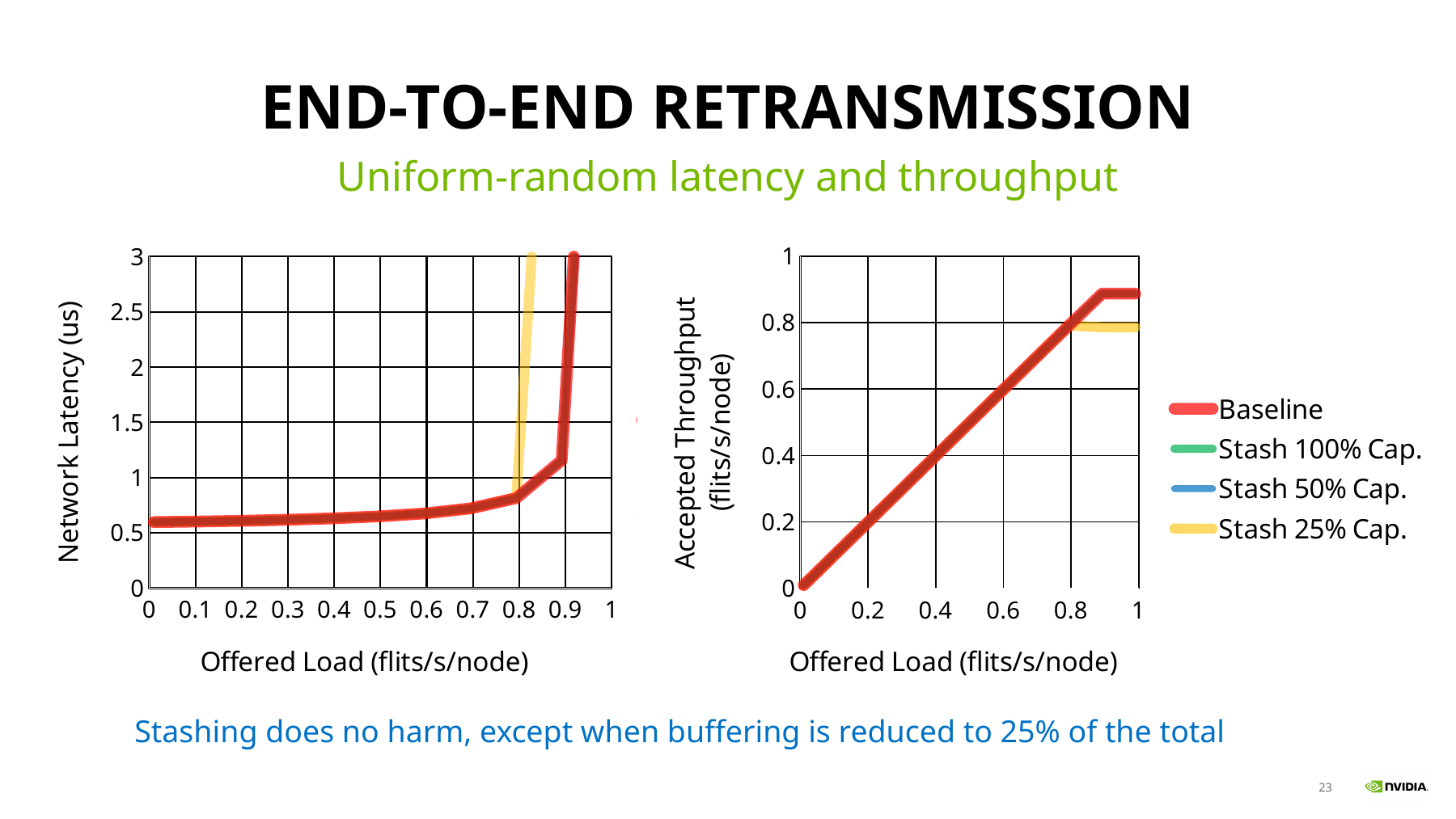
In the right chart, is the Baseline accepted throughput at an offered load of 0.2 greater or less than 0.4? less How many series does the legend list? 4 In the right chart, at an offered load of 1, which series has the higher accepted throughput, Baseline or Stash 25% Cap.? Baseline In the left chart, is the Baseline network latency at an offered load of 0 greater or less than 0.5? greater In the left chart, does the Baseline network latency rise or fall as offered load increases? rise In the right chart, does the Baseline accepted throughput rise or fall as offered load increases from 0 to 0.8? rise What kind of chart is the left chart (Network Latency vs Offered Load)? line chart Which series is shown in yellow in the legend? Stash 25% Cap. In the right chart, is the Baseline accepted throughput at an offered load of 1 greater or less than 0.8? greater What is the y-axis title of the left chart? Network Latency (us) What kind of chart is the right chart (Accepted Throughput vs Offered Load)? line chart